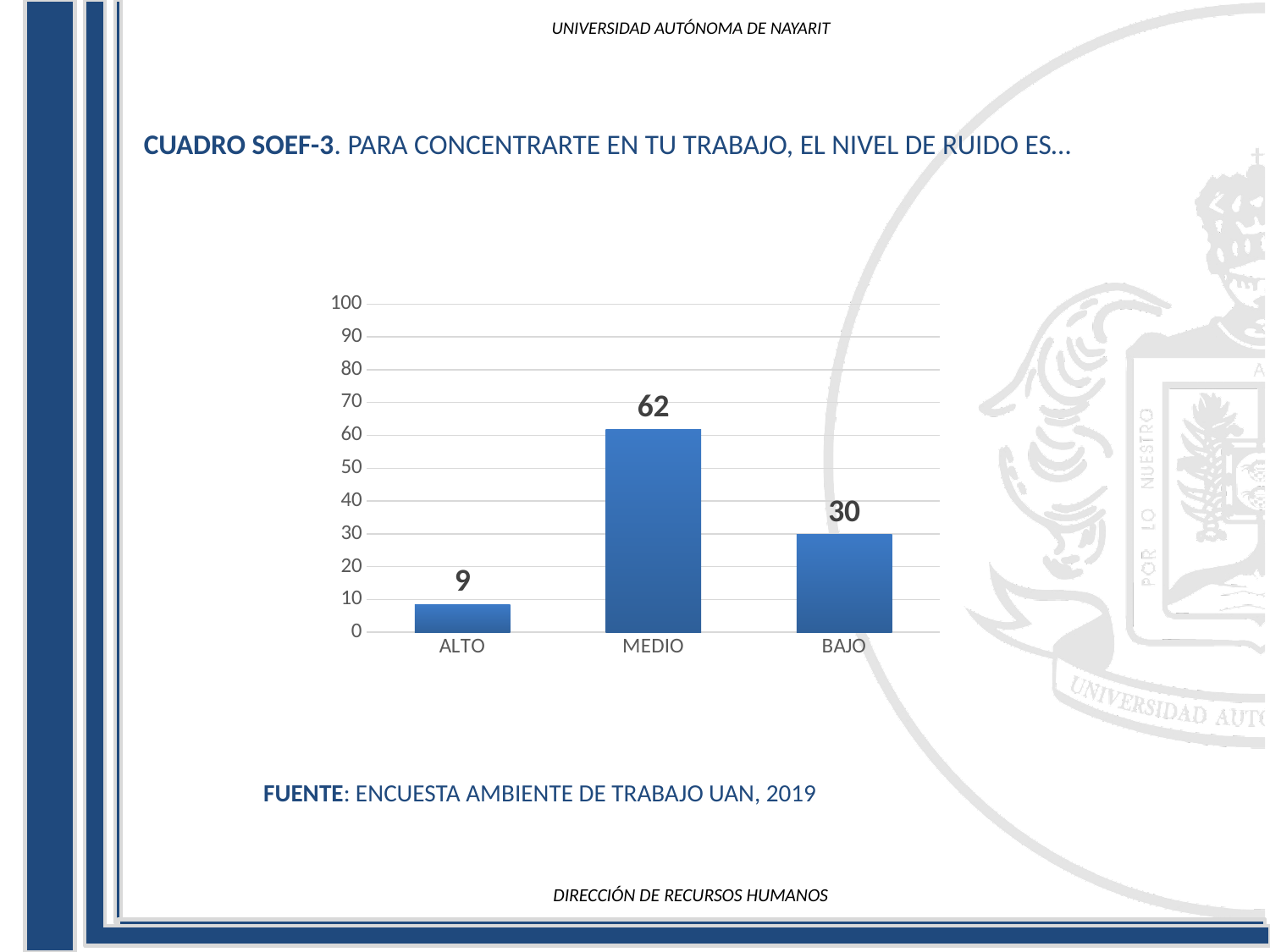
What is the maximum value shown on the vertical axis? 100 What is the difference between the values for BAJO and ALTO? 21 What is the value for BAJO? 30 Is the value for MEDIO greater or less than 50? greater What is the value for ALTO? 9 What kind of chart is shown on the slide? bar chart How many categories are shown on the x axis? 3 What is the value for MEDIO? 62 Which category has the highest value? MEDIO Which category has the lowest value? ALTO What is the difference between the values for MEDIO and BAJO? 32 Which is larger, the value for BAJO or the value for ALTO? BAJO